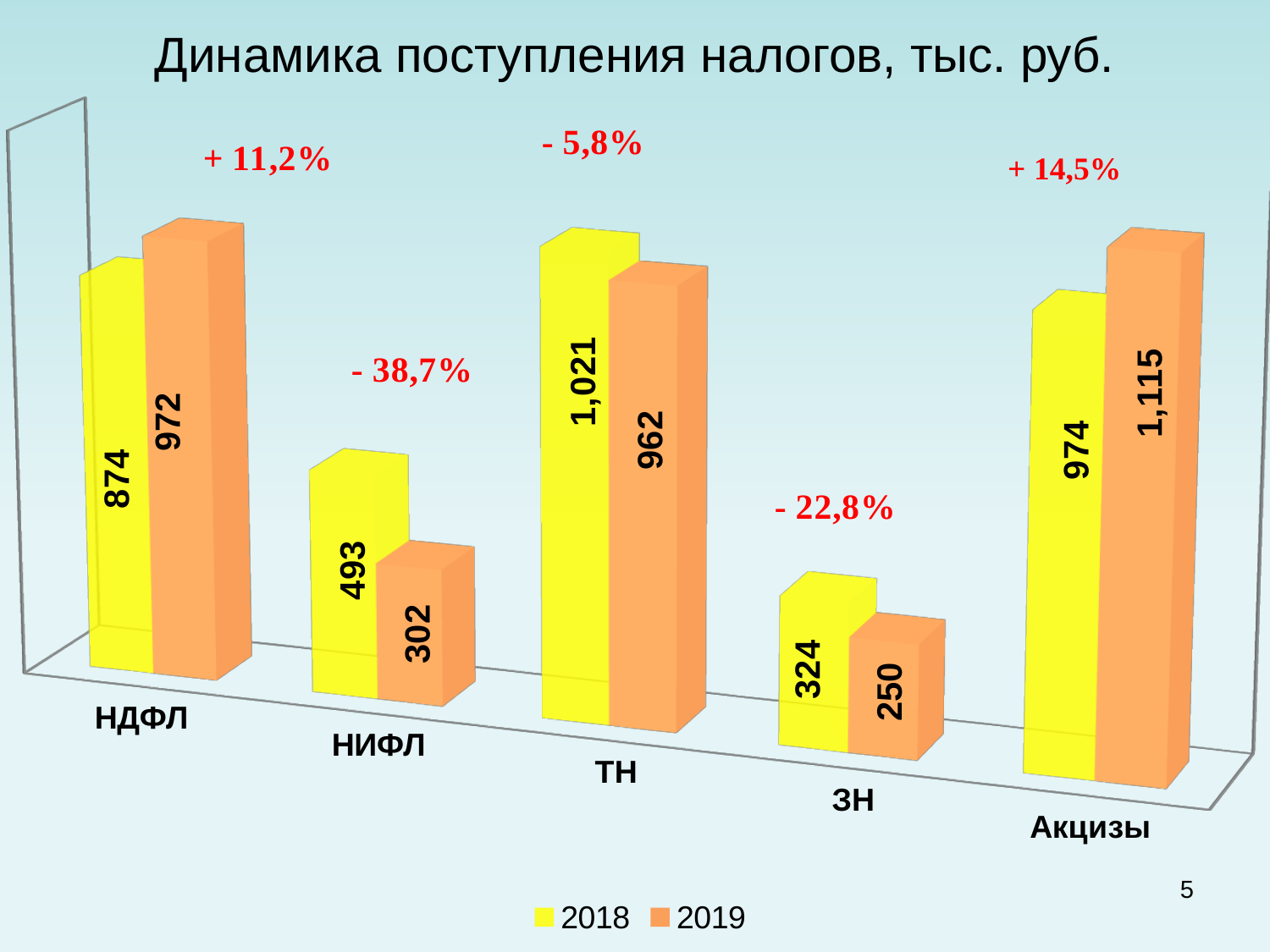
Which category has the highest value in 2019? Акцизы What is the value for ТН in 2018? 1,021 What kind of chart is shown on the slide? Bar chart What is the value for ЗН in 2019? 250 What percentage change is annotated above the ЗН bars? - 22,8% How many categories are shown on the x axis? 5 What is the value for НДФЛ in 2019? 972 How many series does the legend list? 2 What is the difference between the 2018 and 2019 values for НИФЛ? 191 What is the title of the chart? Динамика поступления налогов, тыс. руб. Which is larger for Акцизы: the 2018 value or the 2019 value? 2019 Which category has the lowest value in 2018? ЗН